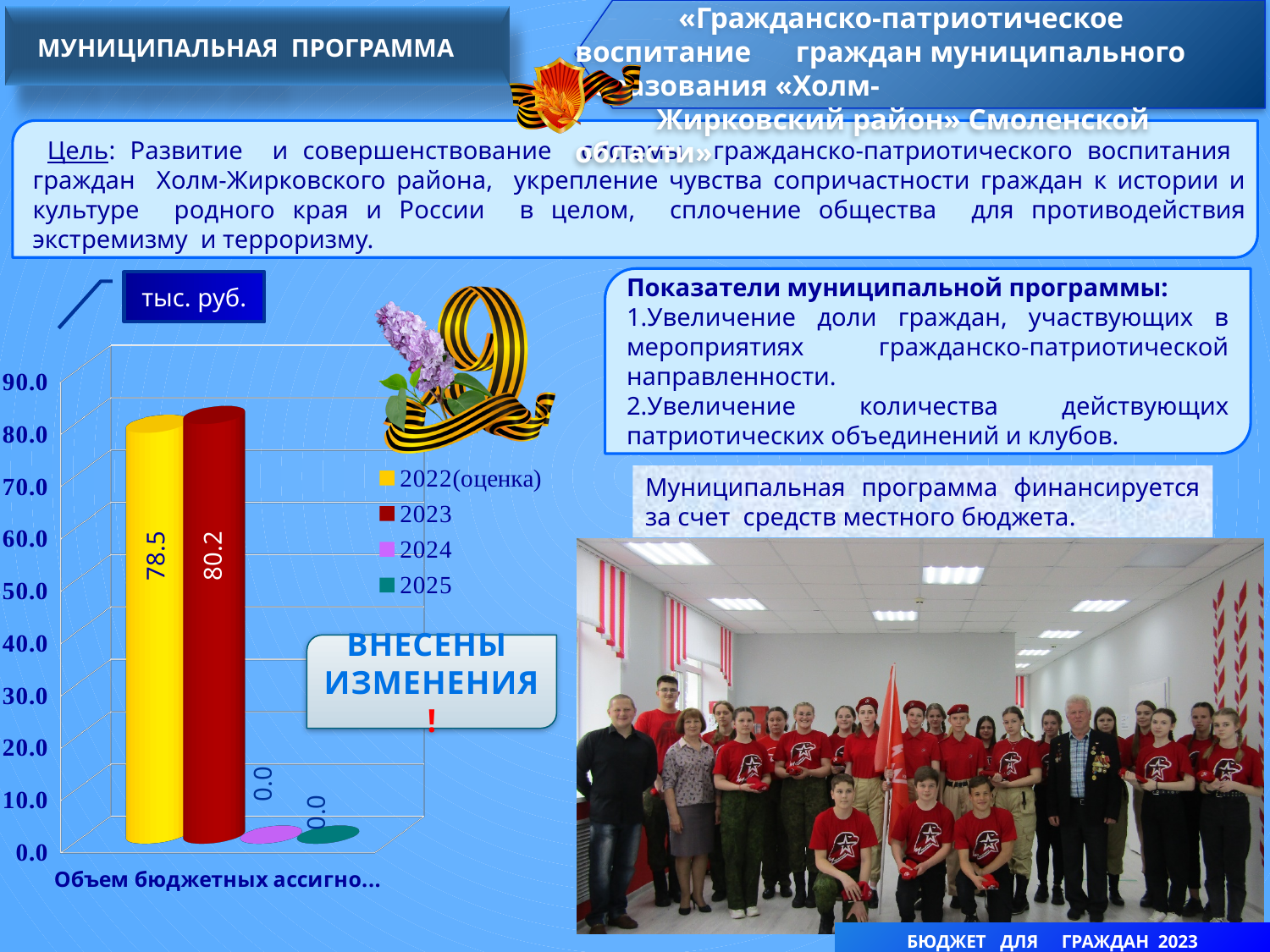
What is the difference between the 2023 value and the 2022(оценка) value? 1.7 What is the value for 2022(оценка) in the chart? 78.5 Which series has the highest value in the chart? 2023 What is the value for 2024 in the chart? 0.0 Is the value for 2022(оценка) greater or less than 70.0? greater What unit of measurement is indicated for the chart values? тыс. руб. What colour is the bar for 2023 in the chart? dark red What is the value for 2023 in the chart? 80.2 What is the value for 2025 in the chart? 0.0 What type of chart is shown on the slide? bar chart How many series does the chart legend list? 4 Which is larger, the value for 2022(оценка) or the value for 2023? 2023